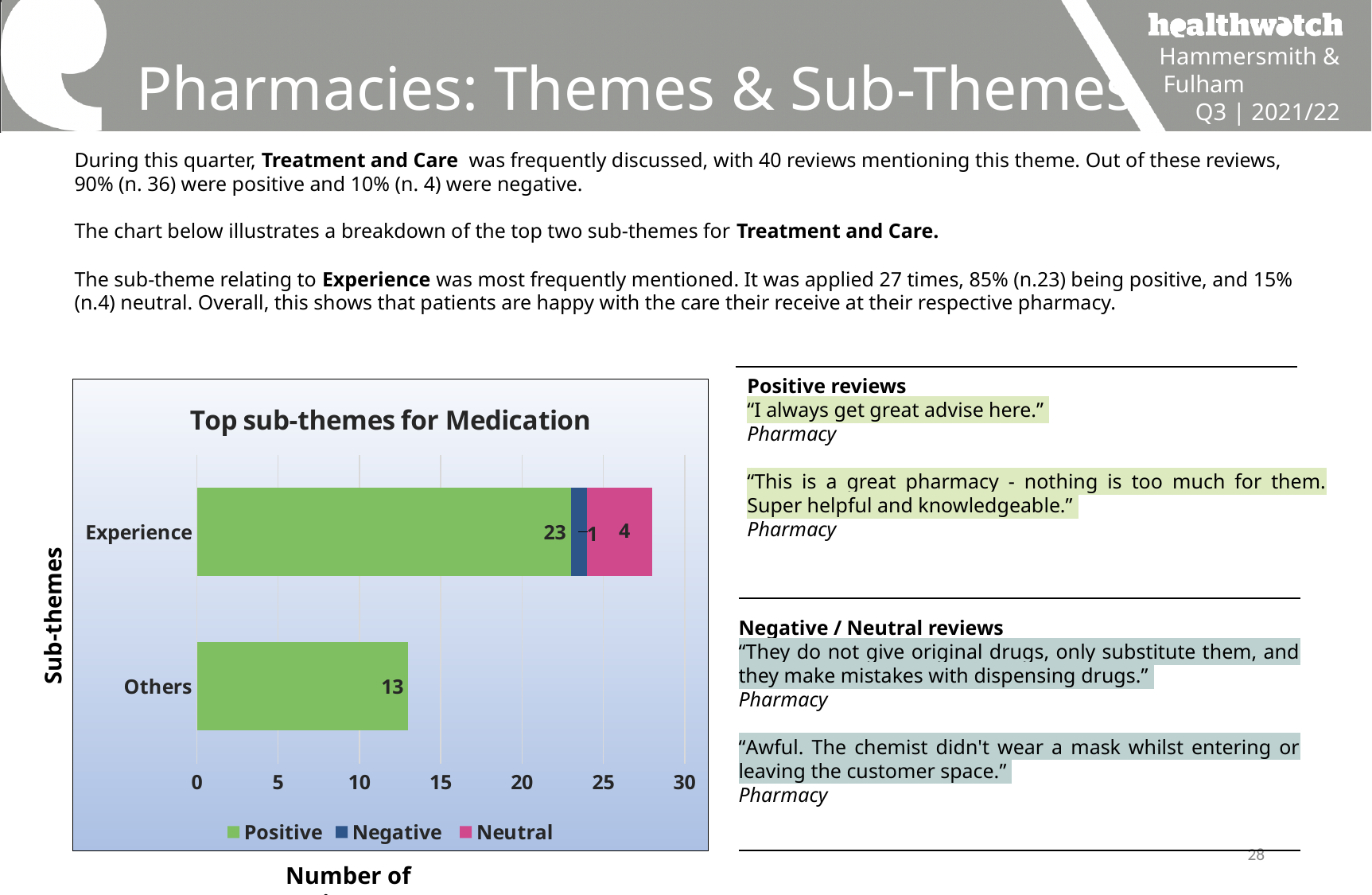
What is the Positive value for Others in the chart? 13 What is the total of the stacked bar for Experience? 28 What is the title of the chart? Top sub-themes for Medication Which sub-theme has the higher Positive value? Experience What is the Negative value for Experience in the chart? 1 What kind of chart is shown on the slide? Stacked bar chart What is the difference between the Positive values for Experience and Others? 10 What is the Positive value for Experience in the chart? 23 Is the Positive value for Others greater or less than 15? less How many sub-themes are shown on the y axis of the chart? 2 What is the Neutral value for Experience in the chart? 4 How many series does the chart legend list? 3